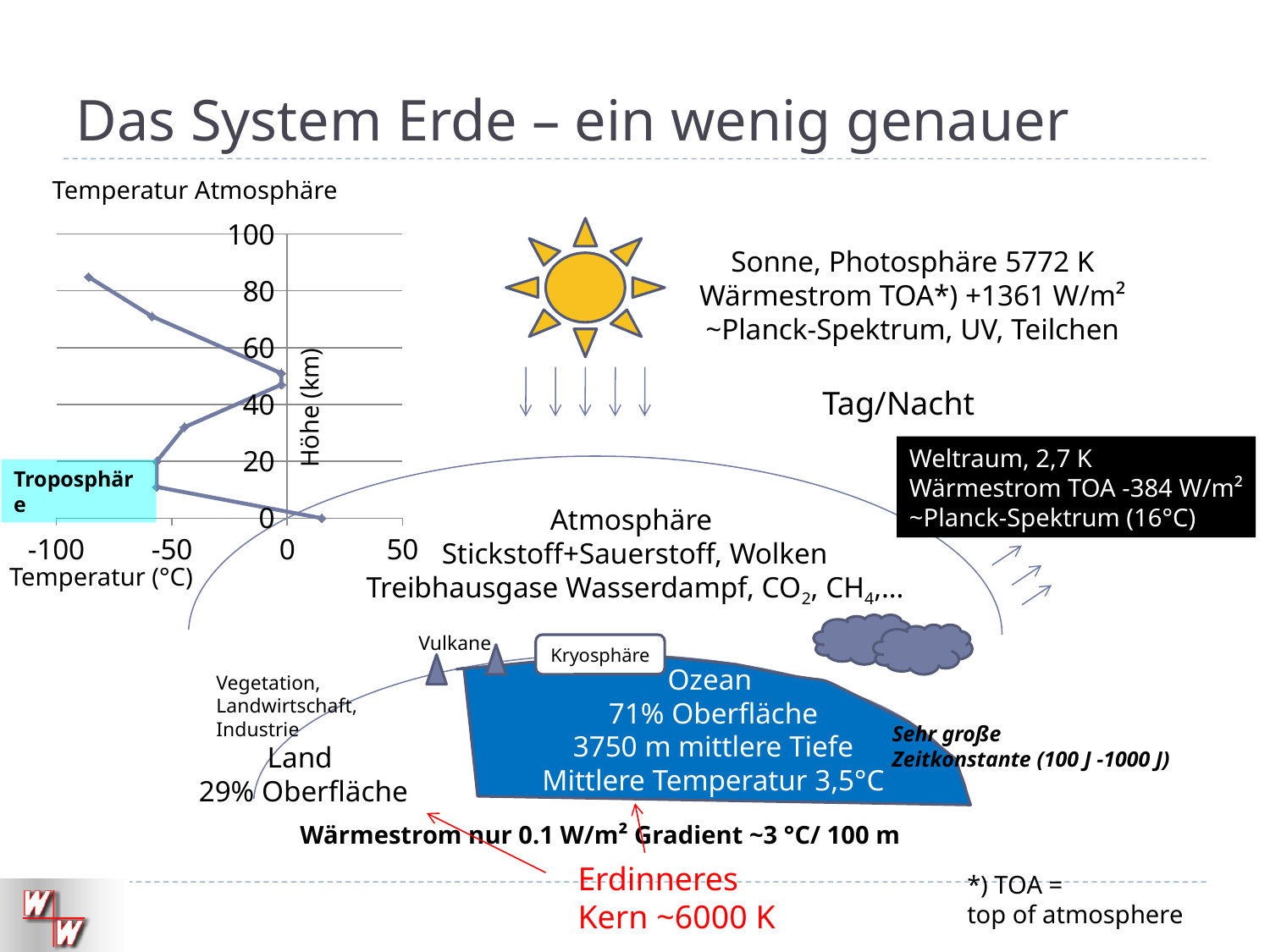
In the 'Temperatur Atmosphäre' chart, is the temperature at a height of 20 km greater or less than -50 °C? less What is the title of the chart on the left of the slide? Temperatur Atmosphäre In the 'Temperatur Atmosphäre' chart, does the temperature rise or fall as height increases from 20 km to about 50 km? rise What is the highest tick value shown on the vertical axis of the 'Temperatur Atmosphäre' chart? 100 In the 'Temperatur Atmosphäre' chart, does the temperature rise or fall as height increases from 0 km to 20 km? fall In the 'Temperatur Atmosphäre' chart, which is warmer: the point at 0 km height or the point at about 85 km height? the point at 0 km What is the label of the vertical axis of the 'Temperatur Atmosphäre' chart? Höhe (km) In the 'Temperatur Atmosphäre' chart, is the temperature at the highest plotted point (above 80 km) greater or less than -50 °C? less What kind of chart is the 'Temperatur Atmosphäre' chart? line chart What is the lowest tick value shown on the horizontal axis of the 'Temperatur Atmosphäre' chart? -100 In the 'Temperatur Atmosphäre' chart, is the temperature at a height of 0 km greater or less than 0 °C? greater